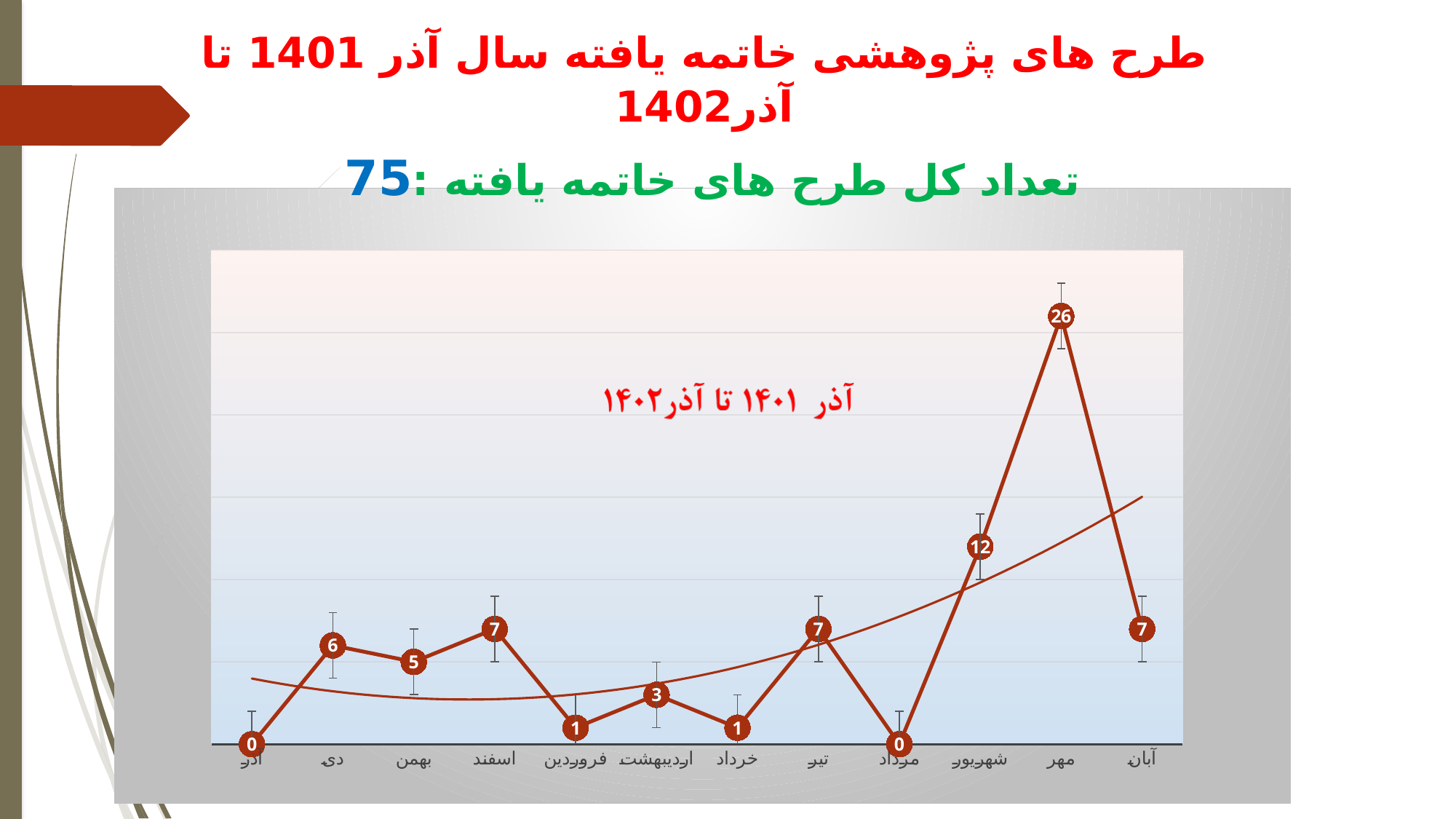
What is the value for دی? 6 Which month has the highest value? مهر Does the value rise or fall from مهر to آبان? fall What is the difference between the values for مهر and شهریور? 14 What is the value for اردیبهشت? 3 Which months have the lowest value? آذر and مرداد What type of chart is shown on the slide? line chart What is the title shown inside the chart area? آذر ۱۴۰۱ تا آذر۱۴۰۲ Which is larger, the value for بهمن or the value for اسفند? اسفند What is the value for مهر? 26 How many months are plotted on the x axis? 12 What is the value for شهریور? 12